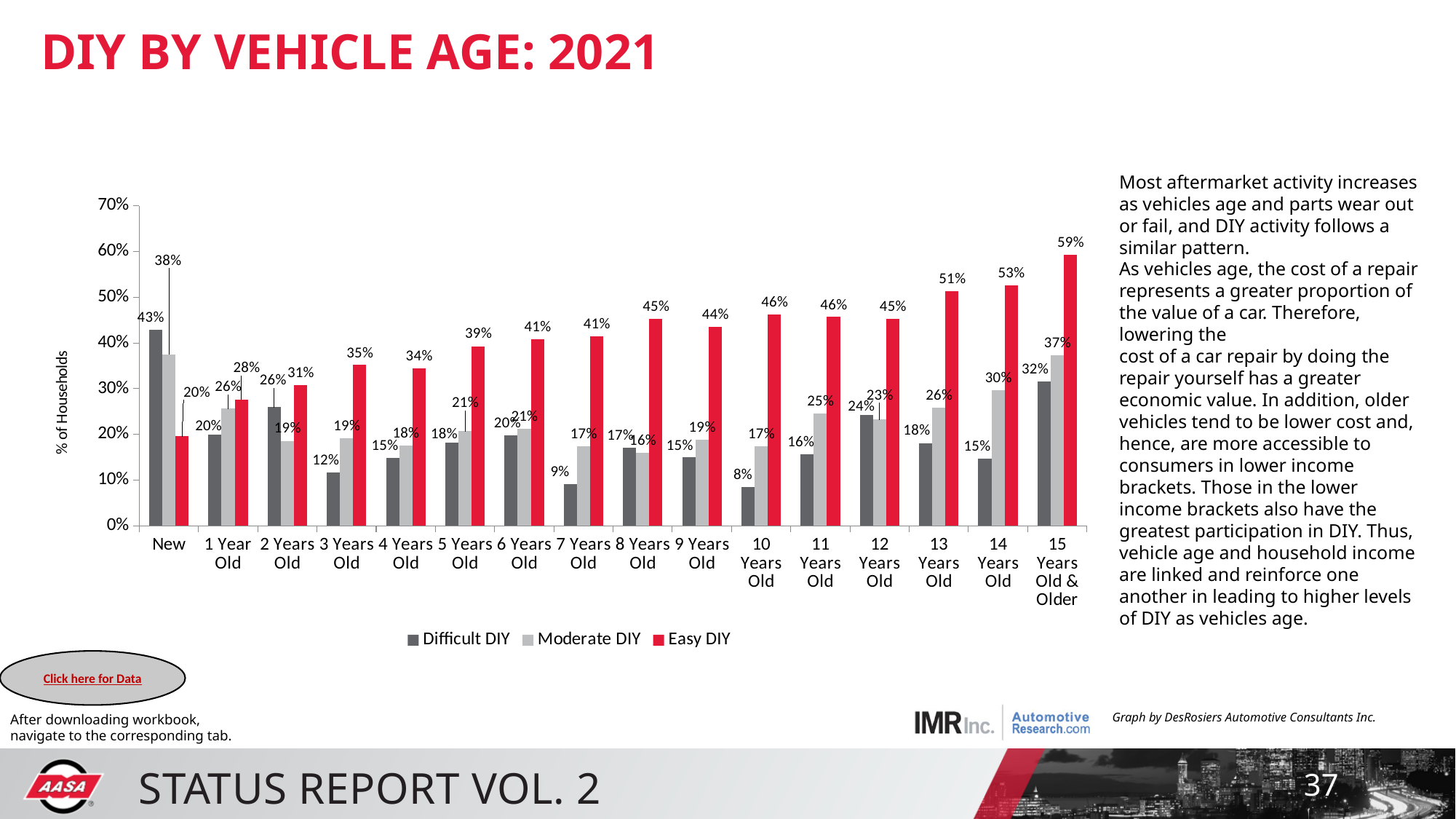
Does the Easy DIY value generally rise or fall as vehicle age increases from New to 15 Years Old & Older? Rise Which vehicle age category has the highest Easy DIY value? 15 Years Old & Older What is the difference between the Easy DIY value for 15 Years Old & Older and the Easy DIY value for New vehicles? 39 percentage points What kind of chart is shown on the slide? Bar chart How many vehicle age categories are shown on the x axis? 16 What is the Moderate DIY value for vehicles 14 Years Old? 30% What is the Difficult DIY value for New vehicles? 43% What is the Easy DIY value for vehicles 15 Years Old & Older? 59% How many series does the legend list? 3 For New vehicles, which is larger: Difficult DIY or Easy DIY? Difficult DIY What colour represents the Easy DIY series in the chart? Red Which vehicle age category has the lowest Difficult DIY value? 10 Years Old